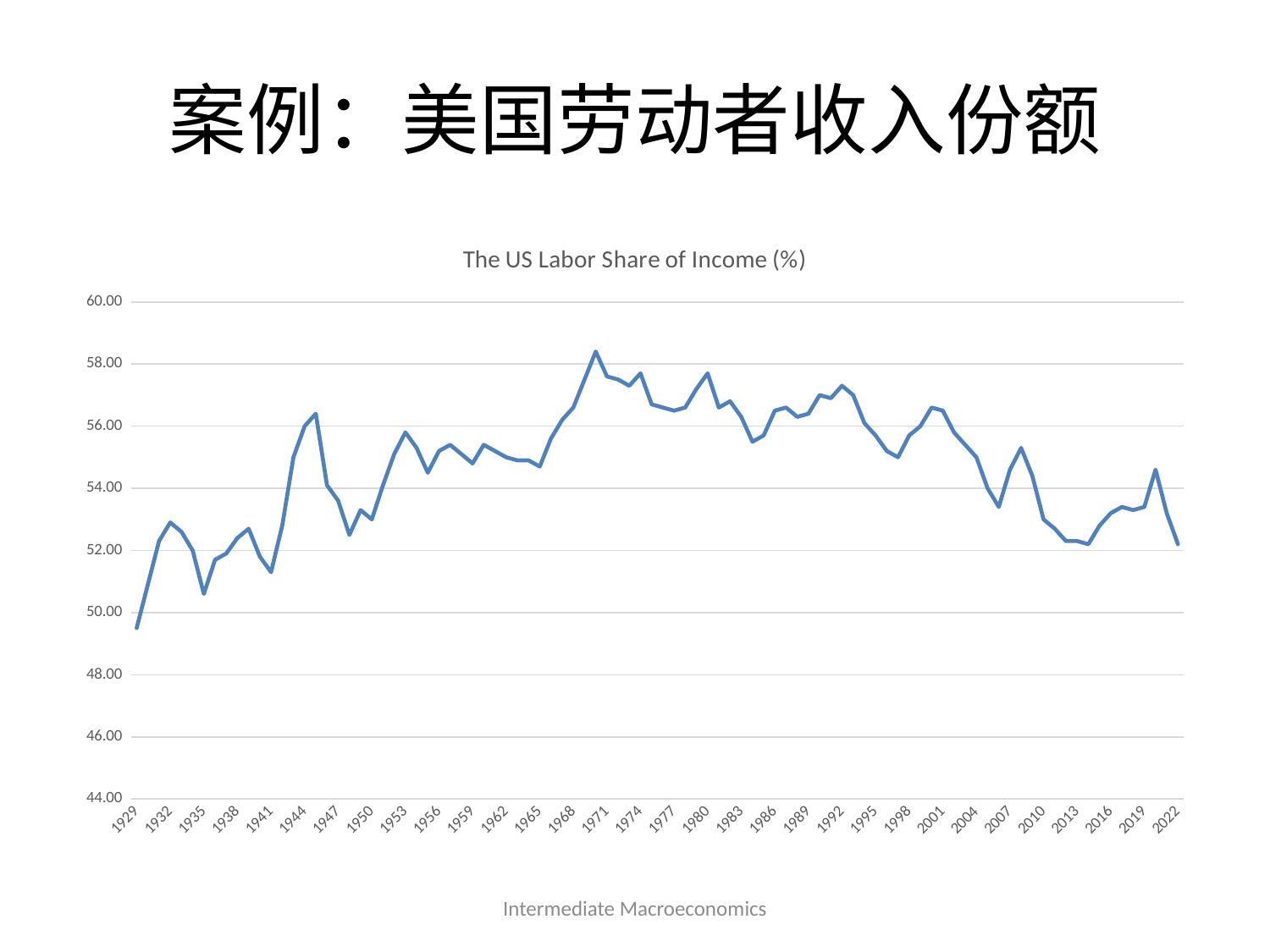
Which is larger, the value for 1944 or the value for 2007? 1944 Which is larger, the value for 1929 or the value for 2022? 2022 Is the value for 2022 greater or less than 54.00? less Which year has the lowest labor share of income on the chart? 1929 What is the title of the chart? The US Labor Share of Income (%) Does the labor share of income generally rise or fall between 2001 and 2013? fall Is the value for 1929 greater or less than 50.00? less Is the value for 2013 greater or less than 54.00? less What is the highest value shown on the vertical axis? 60.00 What kind of chart is shown on the slide? line chart